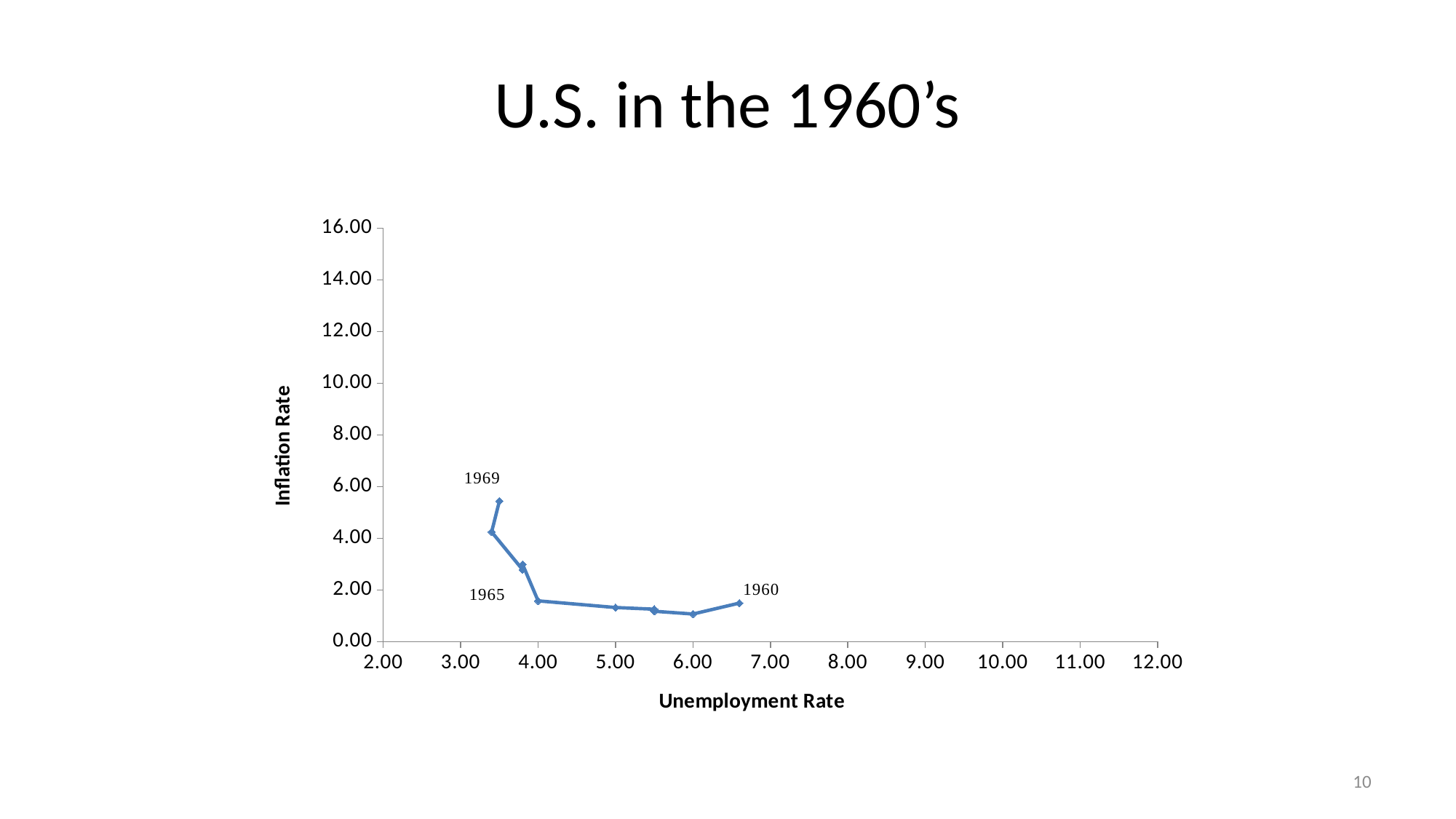
Of the labeled years (1960, 1965, 1969), which has the highest inflation rate? 1969 Is the unemployment rate for the point labeled 1965 greater or less than 5.00? less Is the inflation rate for the point labeled 1960 greater or less than 2.00? less What is the title of the chart on the slide? U.S. in the 1960's As the unemployment rate increases along the x axis, does the inflation rate generally rise or fall? fall Is the unemployment rate for the point labeled 1969 greater or less than 4.00? less Which labeled year has the higher unemployment rate, 1960 or 1965? 1960 What is the label of the horizontal axis? Unemployment Rate Which labeled year has the higher inflation rate, 1969 or 1960? 1969 What kind of chart is shown on the slide? scatter chart with connected points